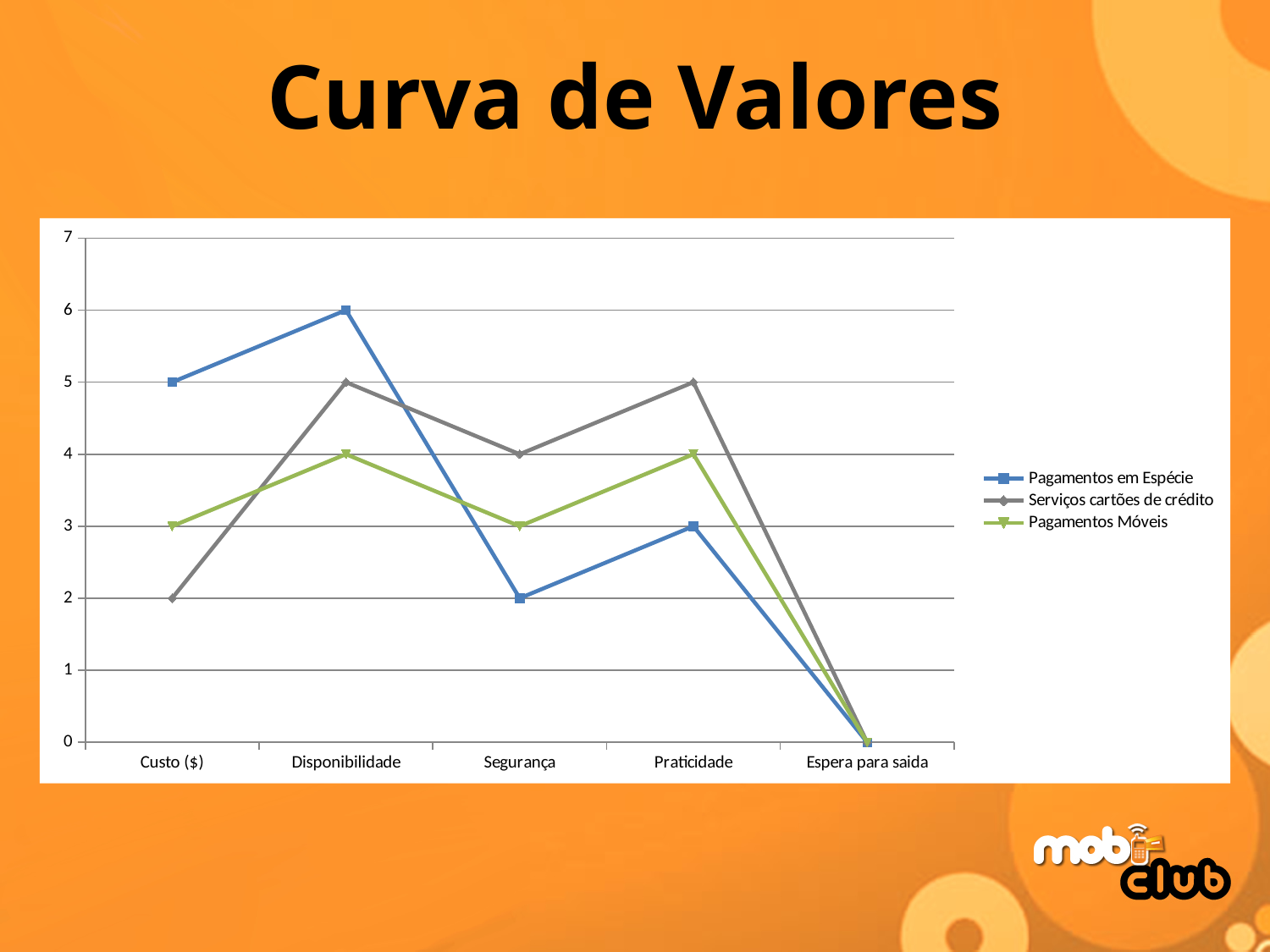
What is the value for Pagamentos Móveis at Praticidade? 4 What is the title of the slide containing the chart? Curva de Valores At which category does Pagamentos em Espécie reach its highest value? Disponibilidade Does the value for Pagamentos em Espécie rise or fall from Disponibilidade to Segurança? Fall What is the value for Pagamentos em Espécie at Disponibilidade? 6 At which category do all three series reach their lowest value? Espera para saida What kind of chart is shown on the slide? Line chart How many categories are shown on the x axis? 5 What is the difference between Pagamentos em Espécie and Serviços cartões de crédito at Custo ($)? 3 How many series does the legend list? 3 What is the value for Serviços cartões de crédito at Custo ($)? 2 Which series has the higher value at Segurança, Pagamentos em Espécie or Serviços cartões de crédito? Serviços cartões de crédito